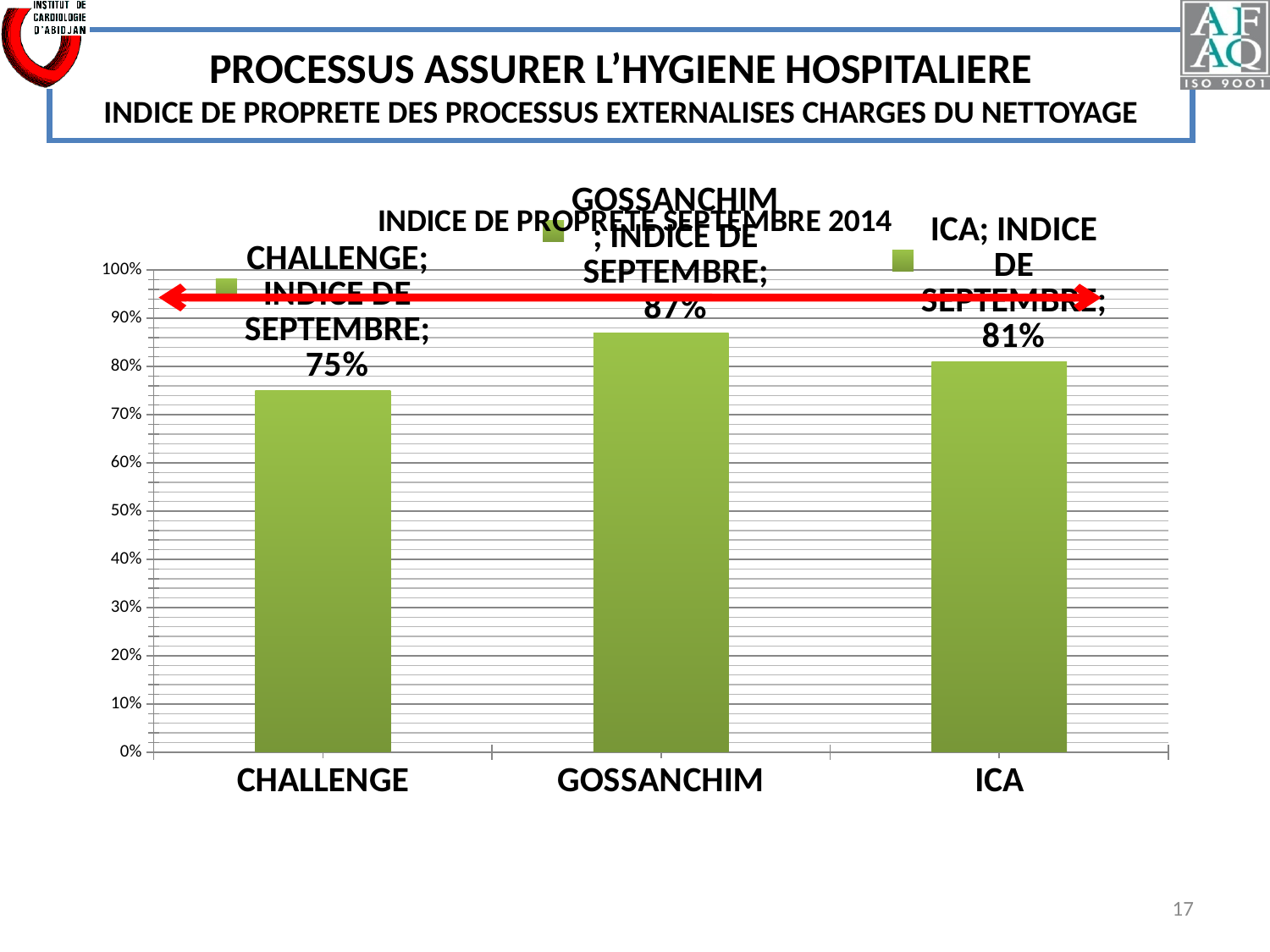
Which category has the highest value? GOSSANCHIM Is the value for GOSSANCHIM greater or less than 80%? greater Which is larger, the value for ICA or the value for CHALLENGE? ICA What is the value for CHALLENGE? 75% What is the difference between the values for ICA and CHALLENGE? 6% What kind of chart is shown on the slide? bar chart What is the difference between the values for GOSSANCHIM and CHALLENGE? 12% What is the value for ICA? 81% How many categories are shown on the x axis? 3 What is the value for GOSSANCHIM? 87% Which category has the lowest value? CHALLENGE What is the title of the chart? INDICE DE PROPRETE SEPTEMBRE 2014